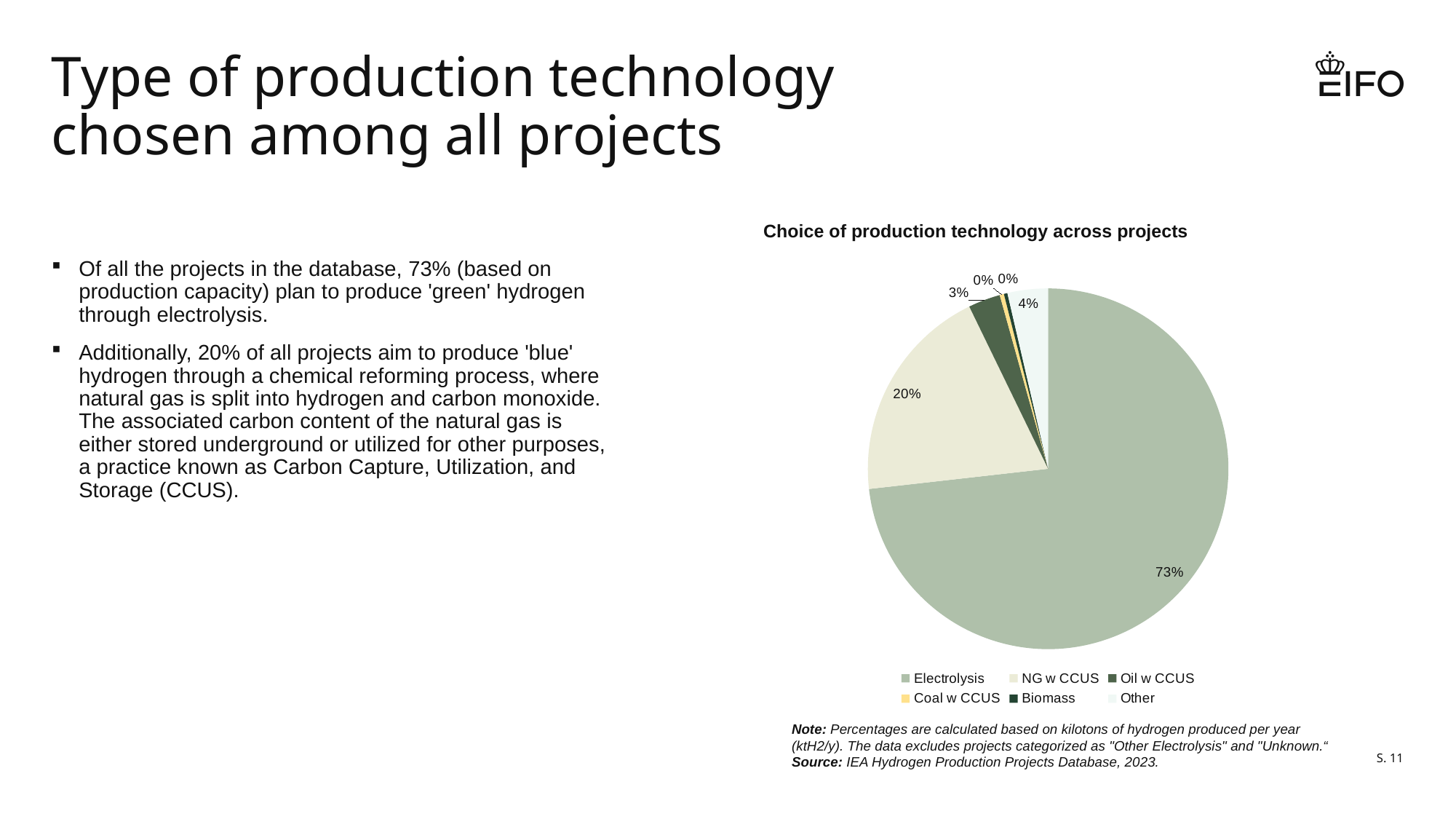
What share of the pie does Electrolysis account for? 73% What is the difference in percentage points between the Electrolysis and NG w CCUS slices? 53 What share of the pie does NG w CCUS account for? 20% What share of the pie does Other account for? 4% What is the title of the chart? Choice of production technology across projects How many categories does the legend list? 6 Which legend entry is shown in yellow? Coal w CCUS Which slice is larger, Other or Oil w CCUS? Other Which category has the largest slice of the pie? Electrolysis What type of chart is shown on the slide? Pie chart What is the combined share of the NG w CCUS and Oil w CCUS slices? 23%